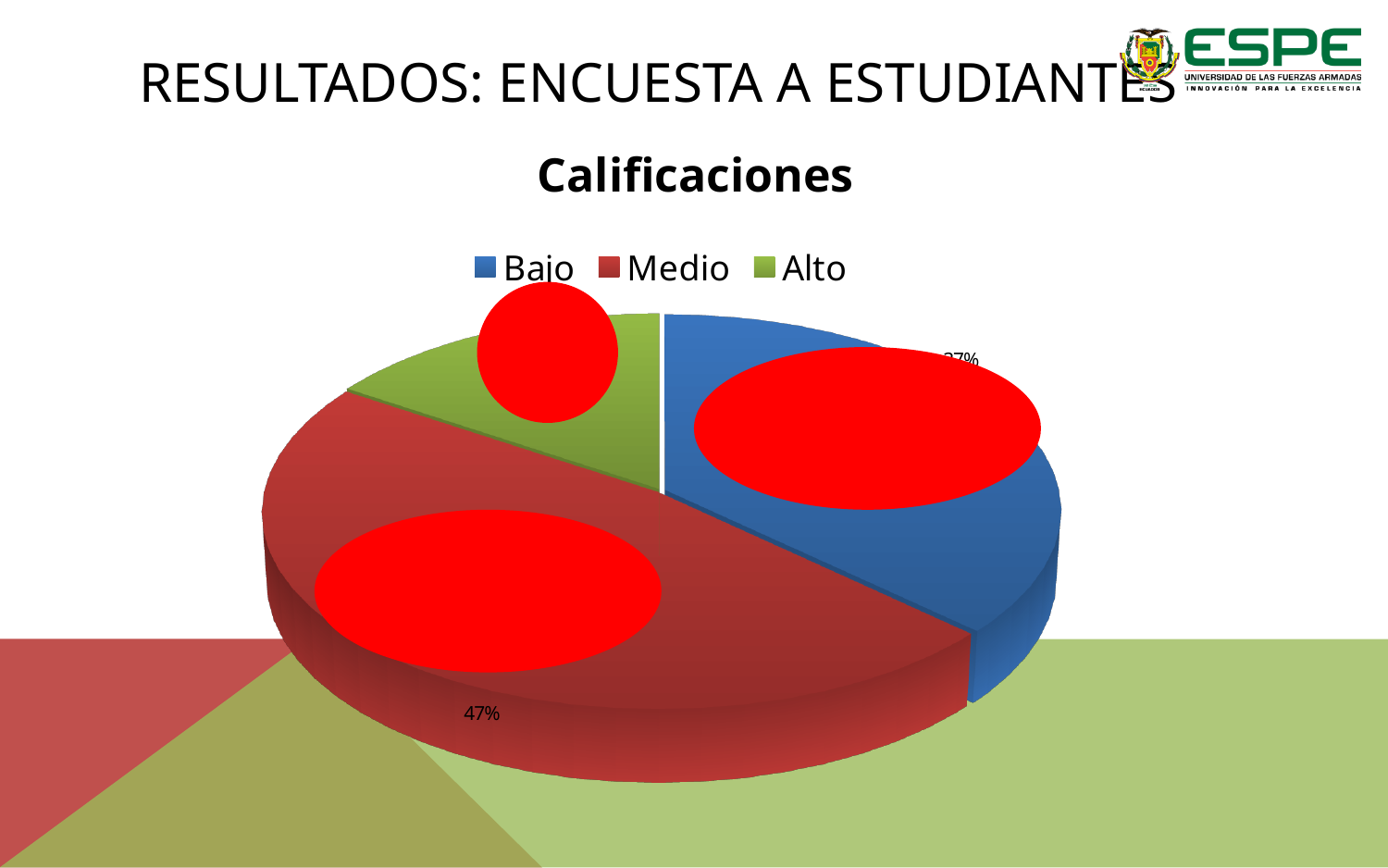
How many slices does the pie chart have? 3 What kind of chart is shown on the slide? pie chart Which category has the smallest slice of the pie? Alto How many categories does the legend list? 3 Which slice is larger, Medio or Bajo? Medio Which slice is larger, Bajo or Alto? Bajo What percentage is shown for the Medio slice? 47% What share of the pie does Medio represent? 47% What is the title of the chart? Calificaciones Which colour represents the Alto category in the chart? green Which category has the largest slice of the pie? Medio